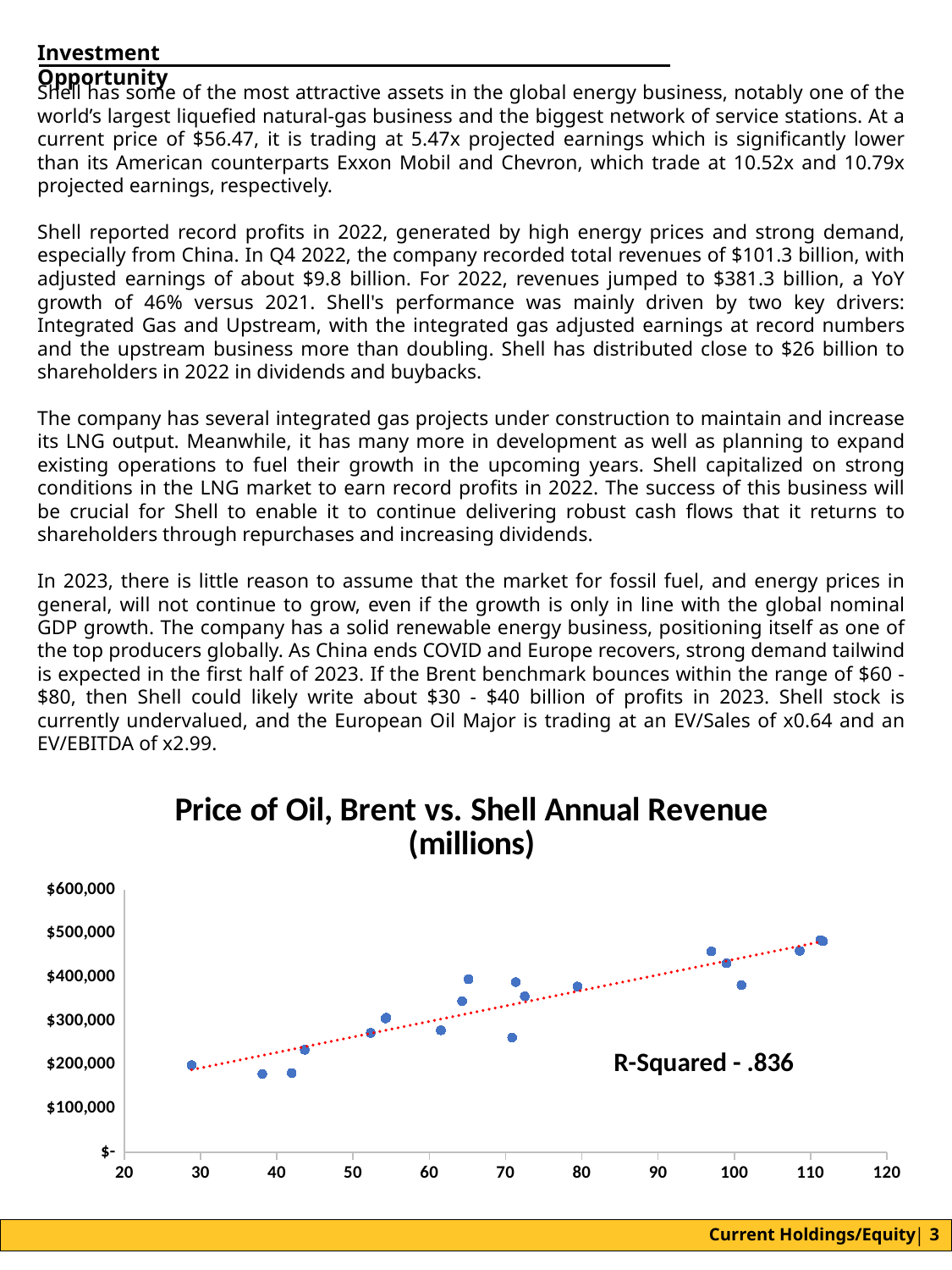
Is the revenue value for the point at an oil price of about 38 greater or less than $200,000? less Is the revenue value for the point at an oil price of about 97 greater or less than $400,000? greater Is the revenue value for the point at an oil price of about 111 greater or less than $400,000? greater What is the highest value shown on the y axis? $600,000 What is the title of the chart? Price of Oil, Brent vs. Shell Annual Revenue (millions) What kind of chart is shown on the slide? scatter chart What R-Squared value is printed on the chart? .836 As the price of oil increases along the x axis, does Shell's annual revenue generally rise or fall? rise Which is larger: the revenue for the point at an oil price of about 29 or the revenue for the point at an oil price of about 111? the point at about 111 Is the point with the highest revenue located at an oil price greater or less than 100? greater